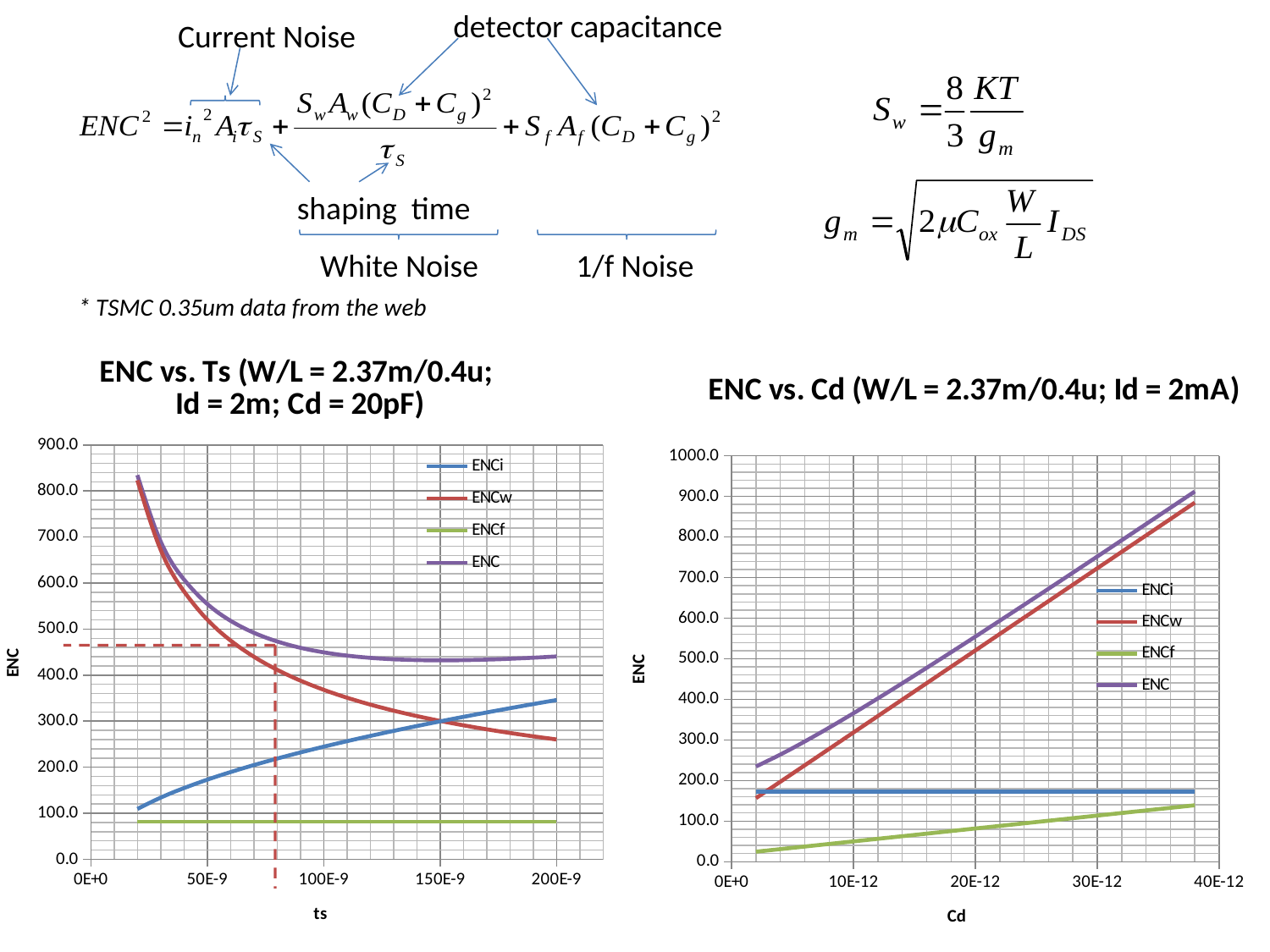
In the 'ENC vs. Ts' chart on the left, which series is larger at ts = 200E-9, ENCi or ENCw? ENCi What kind of chart is the 'ENC vs. Ts' chart on the left? line chart In the 'ENC vs. Ts' chart on the left, does the ENCi series rise or fall as ts increases? rise In the 'ENC vs. Cd' chart on the right, which series is larger at Cd = 30E-12, ENC or ENCf? ENC In the 'ENC vs. Cd' chart on the right, does the ENCw series rise or fall as Cd increases? rise In the 'ENC vs. Cd' chart on the right, is the value of ENCi greater or less than 200? less In the 'ENC vs. Cd' chart on the right, is the value of ENCw at Cd = 10E-12 greater or less than 300? greater In the 'ENC vs. Ts' chart on the left, does the ENCw series rise or fall as ts increases? fall In the 'ENC vs. Ts' chart on the left, is the value of ENCi at ts = 200E-9 greater or less than 300? greater What is the x-axis label of the 'ENC vs. Cd' chart on the right? Cd How many series does the legend of the 'ENC vs. Cd' chart on the right list? 4